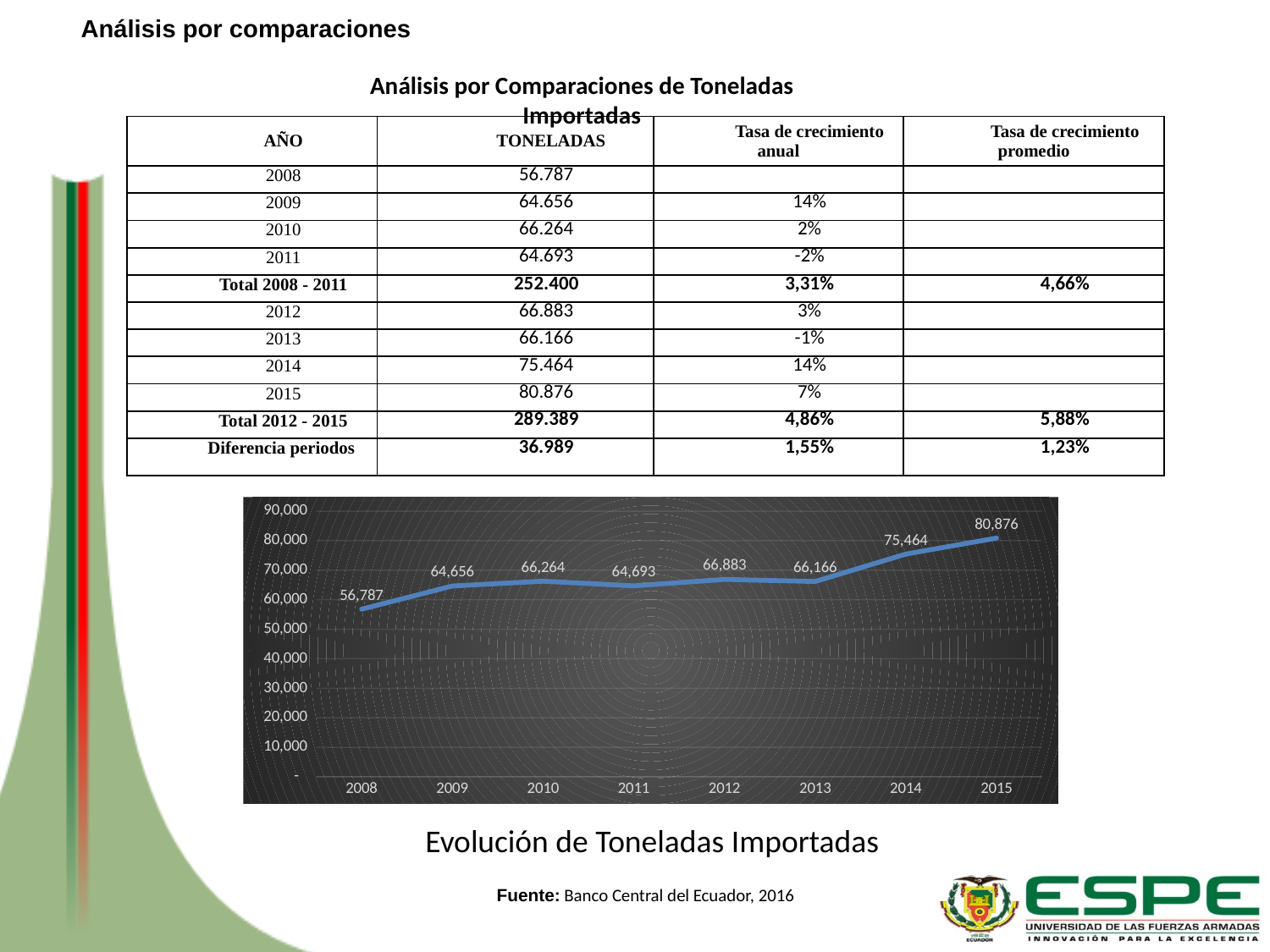
How many years are plotted on the x axis of the line chart? 8 Is the value for 2012 in the line chart greater or less than 60,000? greater What is the value plotted for 2015 in the line chart? 80,876 What is the value plotted for 2011 in the line chart? 64,693 What is the value plotted for 2008 in the line chart? 56,787 What is the difference between the values for 2015 and 2014 in the line chart? 5,412 Which year has the lowest value in the line chart? 2008 What is the title shown below the line chart? Evolución de Toneladas Importadas What is the value plotted for 2014 in the line chart? 75,464 Which year has the highest value in the line chart? 2015 Which is larger in the line chart, the value for 2010 or the value for 2013? 2010 What type of chart is shown on the slide? line chart